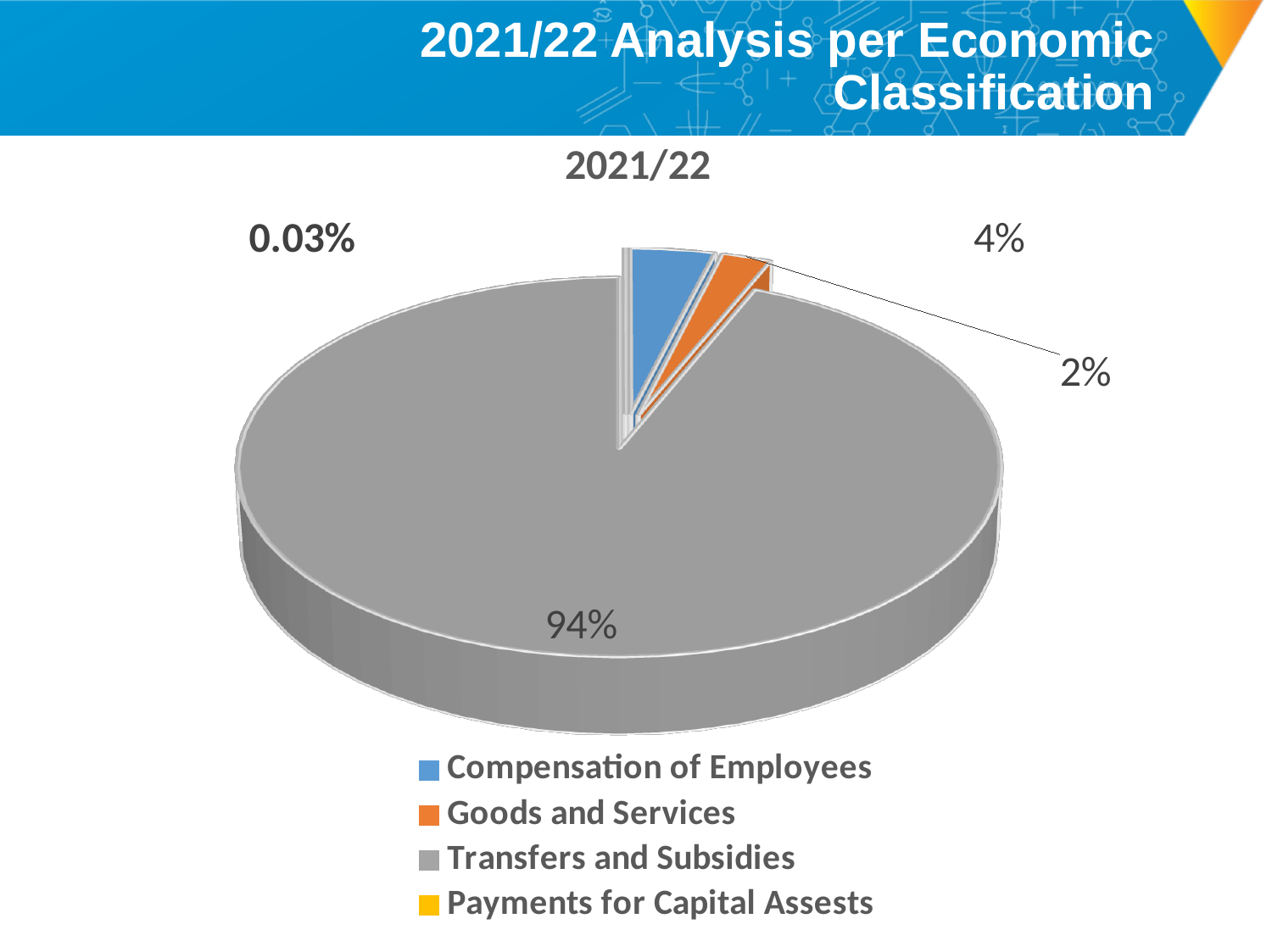
Which category has the largest share of the pie? Transfers and Subsidies What is the chart's title? 2021/22 Which category has the smallest share of the pie? Payments for Capital Assests What share of the pie is Compensation of Employees? 4% What share of the pie is Goods and Services? 2% Which is larger, the share for Compensation of Employees or the share for Goods and Services? Compensation of Employees What colour is the slice for Goods and Services? Orange What kind of chart is shown on the slide? Pie chart How many categories does the legend list? 4 What is the difference between the share for Transfers and Subsidies and the share for Compensation of Employees? 90% What share of the pie is Transfers and Subsidies? 94%